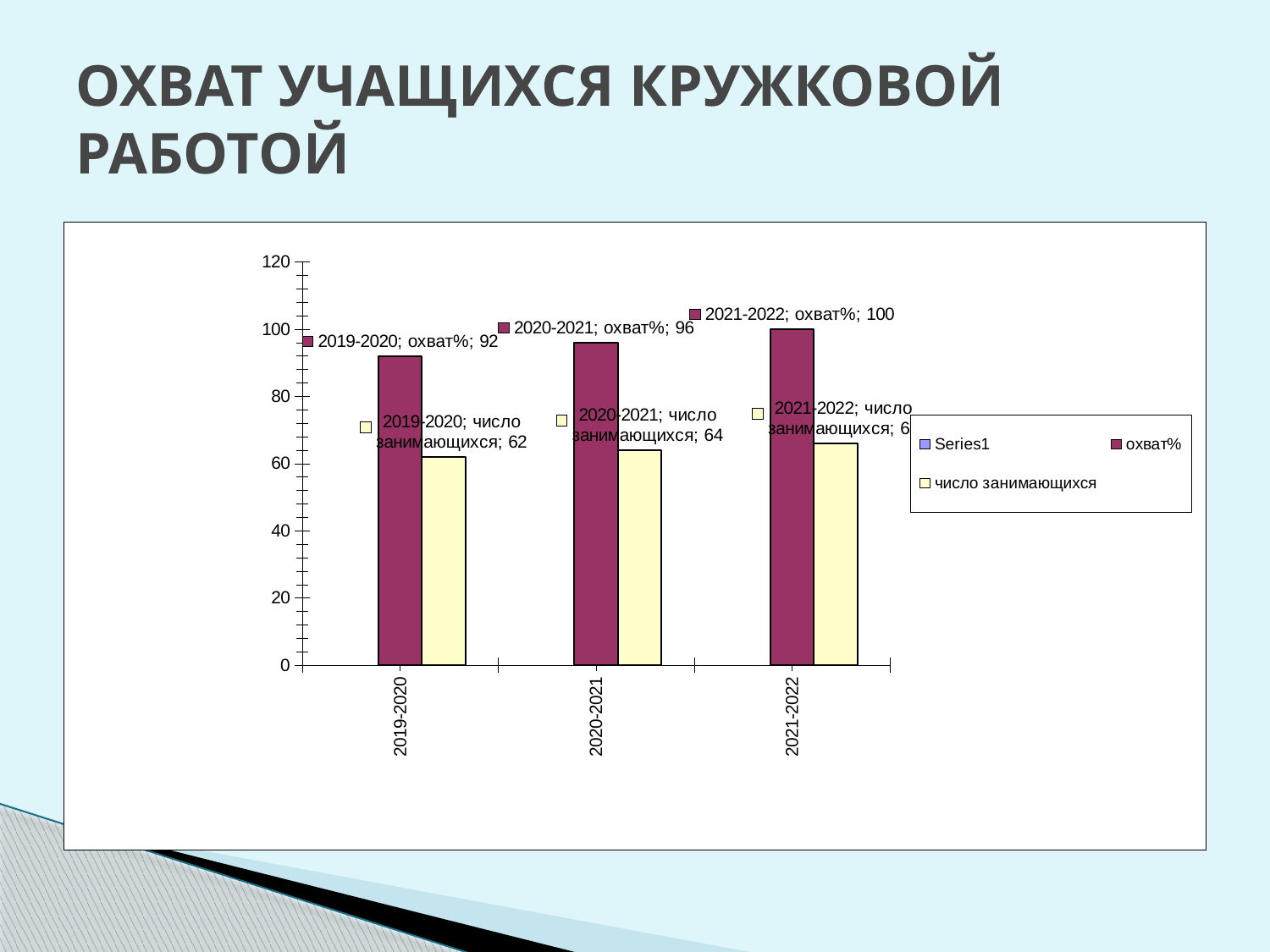
How many year categories are shown on the x axis? 3 Which is larger: охват% for 2020-2021 or число занимающихся for 2020-2021? охват% for 2020-2021 What is the value of охват% for 2019-2020? 92 Which year has the lowest охват% value? 2019-2020 What is the difference between the охват% values for 2021-2022 and 2019-2020? 8 What is the value of число занимающихся for 2019-2020? 62 Which year has the highest охват% value? 2021-2022 Do the охват% values rise or fall from 2019-2020 to 2021-2022? rise Is the value of число занимающихся for 2021-2022 greater or less than 80? less What is the value of охват% for 2021-2022? 100 What kind of chart is shown on the slide? bar chart What is the value of число занимающихся for 2020-2021? 64